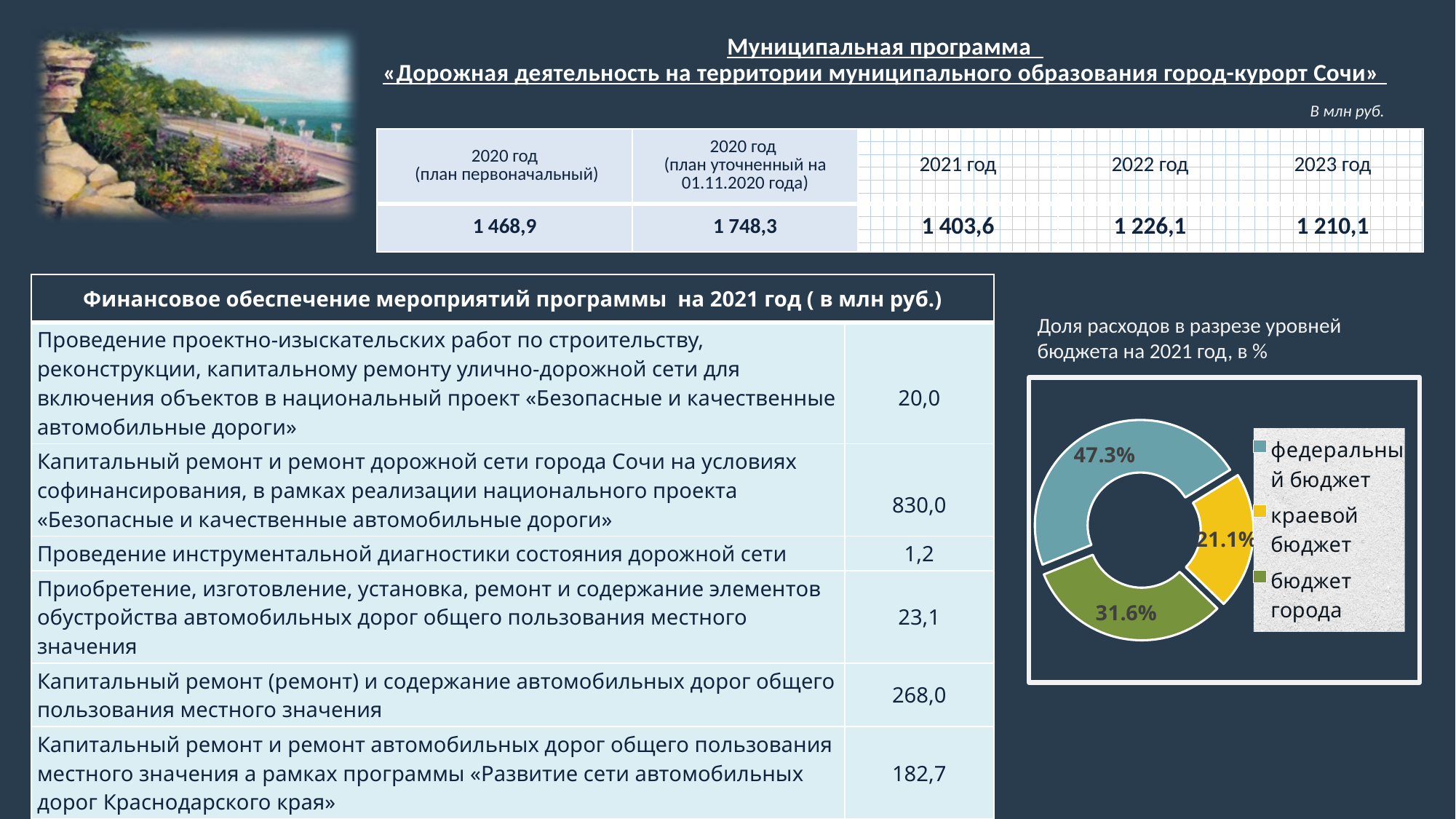
In the pie chart, what share is shown for "бюджет города"? 31.6% What type of chart is shown under the heading "Доля расходов в разрезе уровней бюджета на 2021 год, в %"? Pie chart (doughnut) What is the difference in percentage points between the shares of "бюджет города" and "краевой бюджет" in the pie chart? 10.5 Which budget level has the smallest share in the pie chart? краевой бюджет In the pie chart, what share is shown for "краевой бюджет"? 21.1% What colour is the "краевой бюджет" slice in the pie chart? Yellow How many entries does the legend of the pie chart list? 3 What is the difference in percentage points between the shares of "федеральный бюджет" and "бюджет города" in the pie chart? 15.7 Which budget level has the largest share in the pie chart? федеральный бюджет In the pie chart, what share is shown for "федеральный бюджет"? 47.3% In the pie chart, which is larger: the share of "бюджет города" or the share of "краевой бюджет"? бюджет города How many slices does the pie chart have? 3